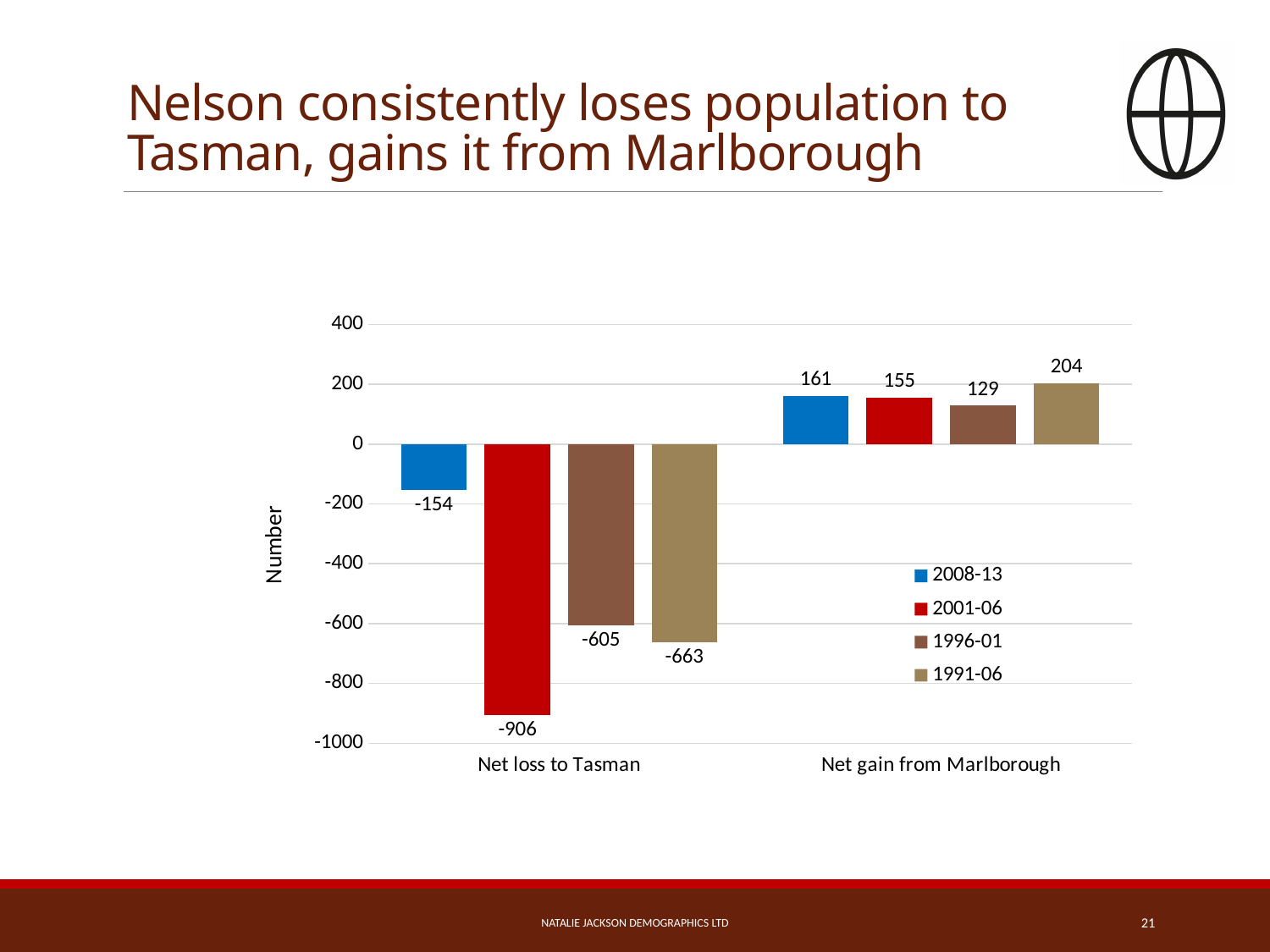
Which period has the largest net gain from Marlborough? 1991-06 What is the value for 2001-06 in the Net loss to Tasman category? -906 Which period has the smallest net gain from Marlborough? 1996-01 What is the value for 1996-01 in the Net gain from Marlborough category? 129 What is the difference between the 2008-13 and 2001-06 values for Net gain from Marlborough? 6 Which is larger in magnitude for Net loss to Tasman: 1996-01 or 1991-06? 1991-06 What is the value for 2008-13 in the Net loss to Tasman category? -154 What is the label on the vertical axis? Number What is the value for 1991-06 in the Net gain from Marlborough category? 204 Which period has the largest net loss to Tasman? 2001-06 What kind of chart is shown on the slide? Bar chart How many series does the legend list? 4